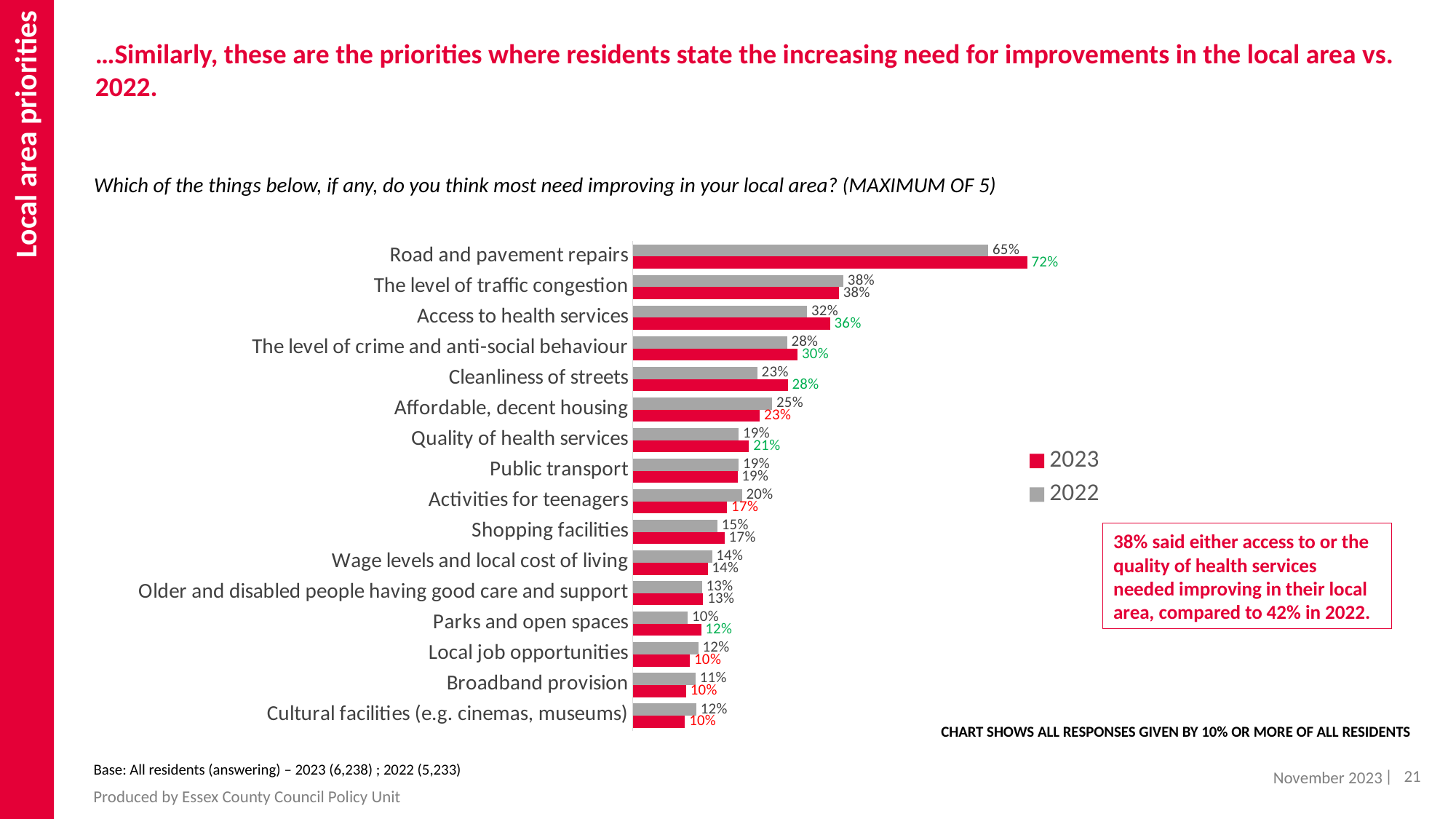
For Affordable, decent housing, which year has the larger value, 2023 or 2022? 2022 What is the difference between the 2022 and 2023 values for Activities for teenagers? 3% What is the 2023 value for Road and pavement repairs? 72% What is the 2023 value for Cleanliness of streets? 28% Which category has the lowest 2022 value? Parks and open spaces Which is larger: the 2023 value for Access to health services or the 2023 value for The level of crime and anti-social behaviour? Access to health services Which category has the highest 2023 value? Road and pavement repairs How many series does the legend list? 2 What is the difference between the 2023 and 2022 values for Road and pavement repairs? 7% How many categories are shown in the chart? 16 What type of chart is shown on the slide? Bar chart What is the 2022 value for Access to health services? 32%